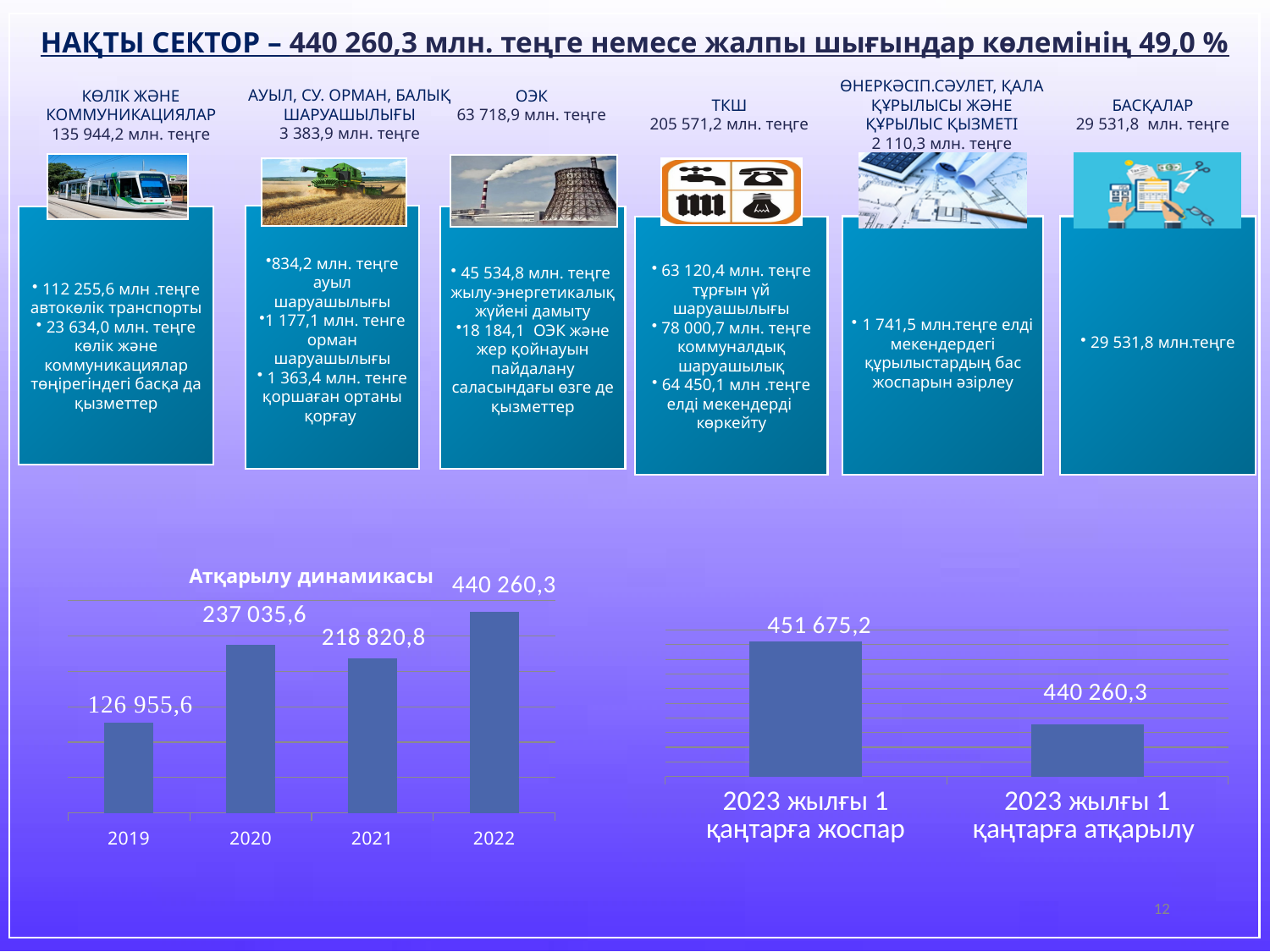
In the 'Атқарылу динамикасы' chart, what is the value for 2021? 218 820,8 How many years are shown in the 'Атқарылу динамикасы' chart? 4 In the chart on the right of the slide, what is the difference between the plan and the actual values? 11 414,9 In the 'Атқарылу динамикасы' chart, which is larger, the value for 2020 or the value for 2021? 2020 In the 'Атқарылу динамикасы' chart, which year has the highest value? 2022 In the chart on the right of the slide, what is the value for '2023 жылғы 1 қаңтарға атқарылу'? 440 260,3 In the chart on the right of the slide, which bar is taller, the plan or the actual? 2023 жылғы 1 қаңтарға жоспар In the 'Атқарылу динамикасы' chart, what is the difference between the values for 2022 and 2021? 221 439,5 What kind of chart is the 'Атқарылу динамикасы' chart? bar chart In the chart on the right of the slide, what is the value for '2023 жылғы 1 қаңтарға жоспар'? 451 675,2 In the 'Атқарылу динамикасы' chart, what is the value for 2019? 126 955,6 In the 'Атқарылу динамикасы' chart, which year has the lowest value? 2019